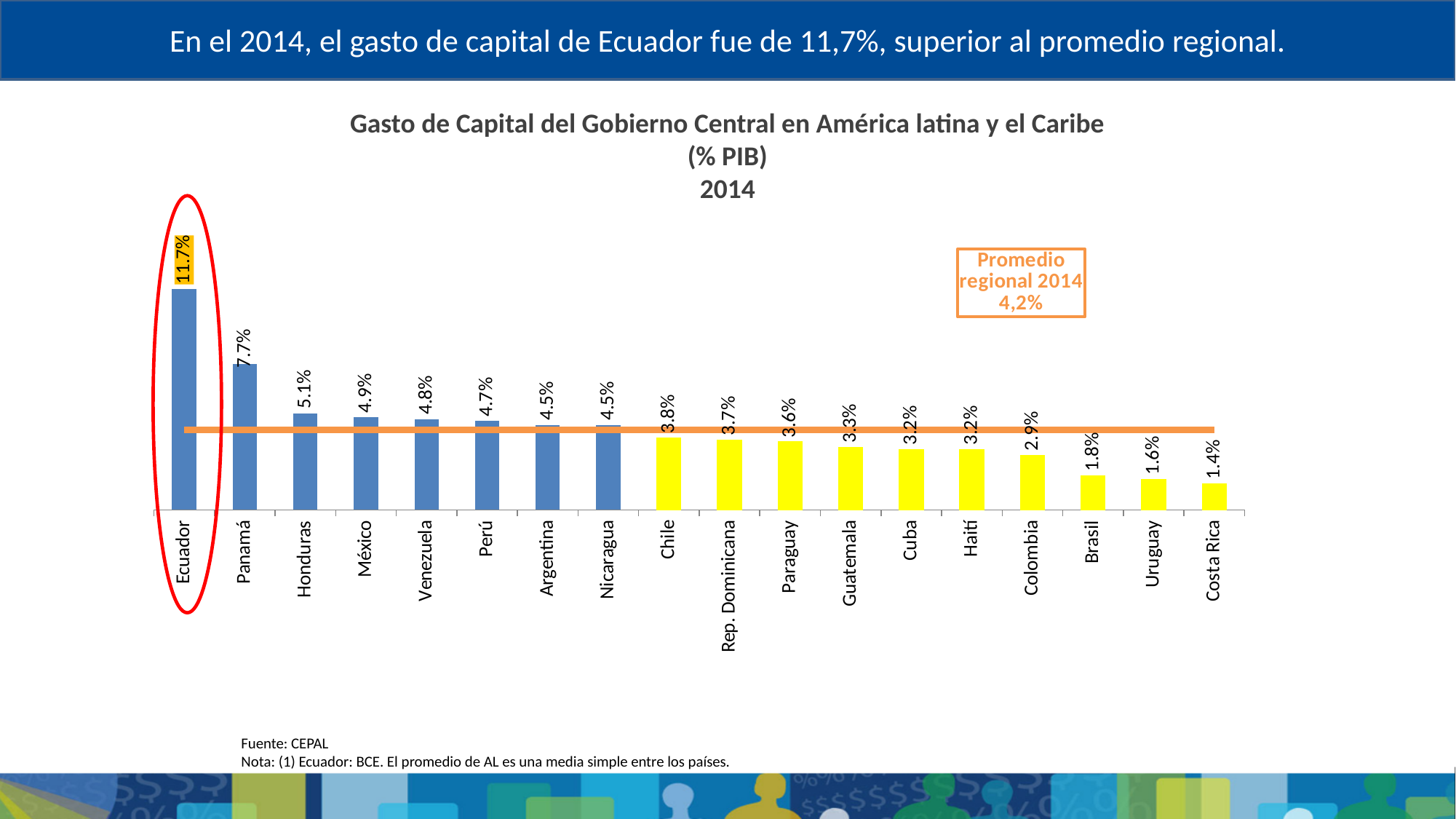
What is the value shown for Rep. Dominicana? 3.7% What is the difference between the values for Ecuador and Panamá? 4.0% What is the regional average for 2014 shown in the orange box? 4,2% What is the value shown for Costa Rica? 1.4% Which has a larger value, Honduras or Chile? Honduras How many countries are shown in the chart? 18 Which country has the lowest capital expenditure in the chart? Costa Rica What type of chart is shown on the slide? Bar chart What is the value shown for Panamá? 7.7% Which country has the highest capital expenditure in the chart? Ecuador What is the capital expenditure value shown for Ecuador? 11.7% Do the values rise or fall moving from left to right along the x axis? Fall